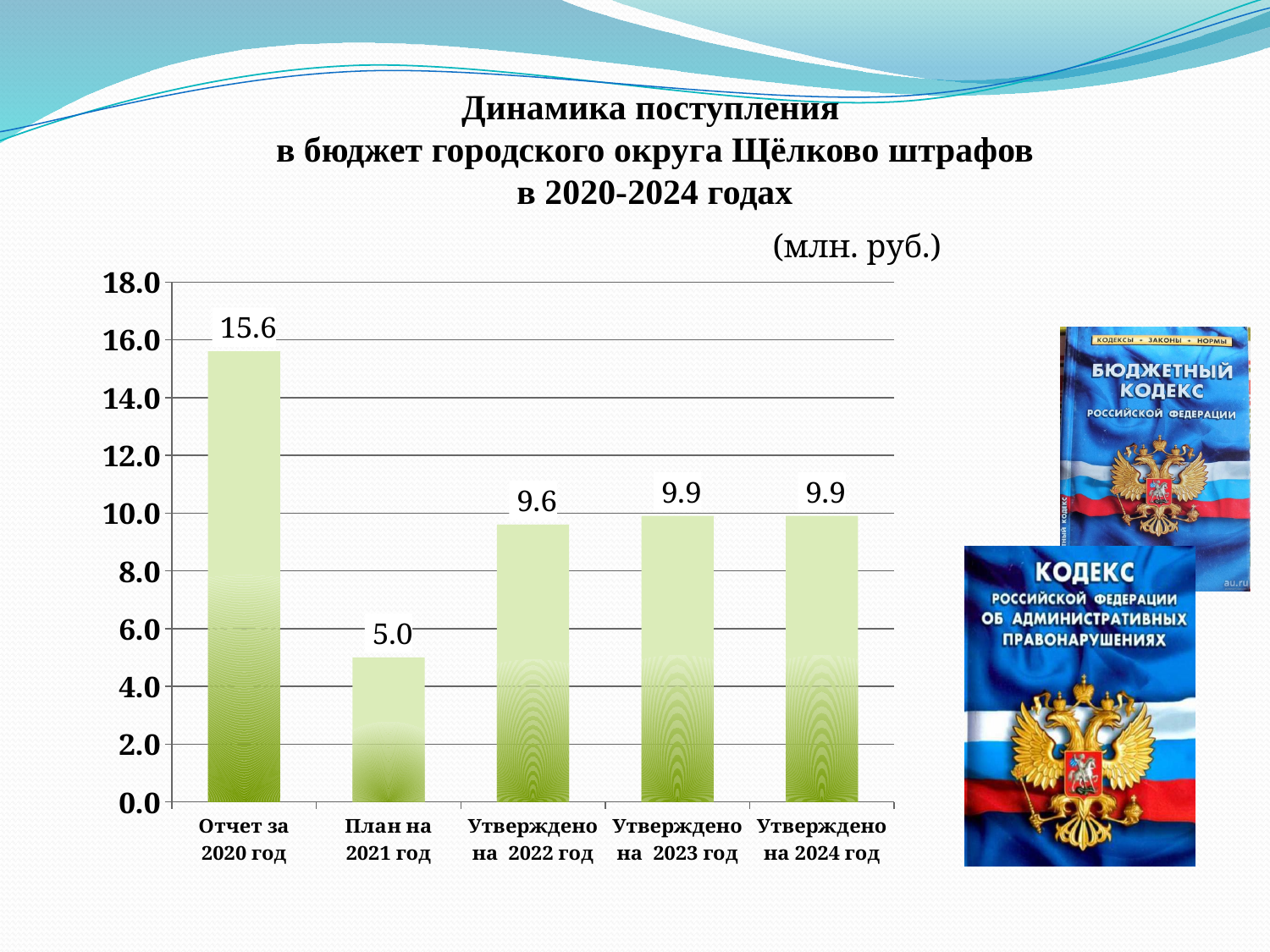
What is the difference between the values for "Утверждено на 2023 год" and "Утверждено на 2022 год"? 0.3 What kind of chart is shown on the slide? Bar chart Which category has the lowest value? План на 2021 год What is the value for "Отчет за 2020 год"? 15.6 How many categories are shown on the chart? 5 What is the value for "Утверждено на 2022 год"? 9.6 What is the value for "Утверждено на 2024 год"? 9.9 What is the value for "План на 2021 год"? 5.0 What unit of measurement is indicated for the chart values? млн. руб. Which is larger: the value for "Утверждено на 2022 год" or "План на 2021 год"? Утверждено на 2022 год What is the difference between the values for "Отчет за 2020 год" and "План на 2021 год"? 10.6 Which category has the highest value? Отчет за 2020 год